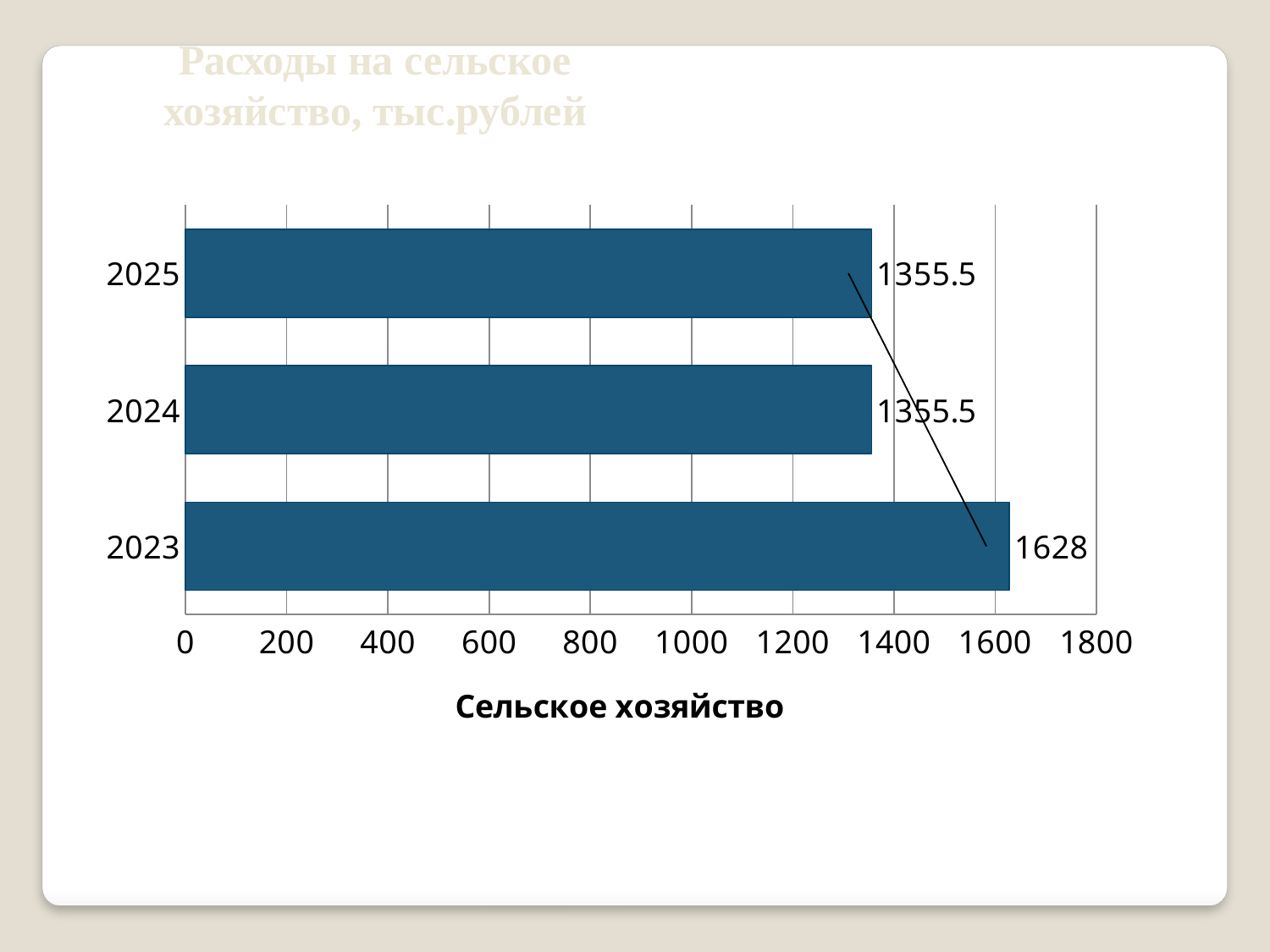
What is the title of the chart? Расходы на сельское хозяйство, тыс.рублей What is the value for 2025? 1355.5 Is the value for 2024 greater or less than 1400? less What is the series name shown below the x axis? Сельское хозяйство Which is larger, the value for 2023 or the value for 2025? 2023 What kind of chart is shown on the slide? bar chart Which year has the highest value? 2023 What is the value for 2024? 1355.5 What is the value for 2023? 1628 What is the difference between the values for 2023 and 2024? 272.5 Is the value for 2023 greater or less than 1600? greater How many years are shown in the chart? 3